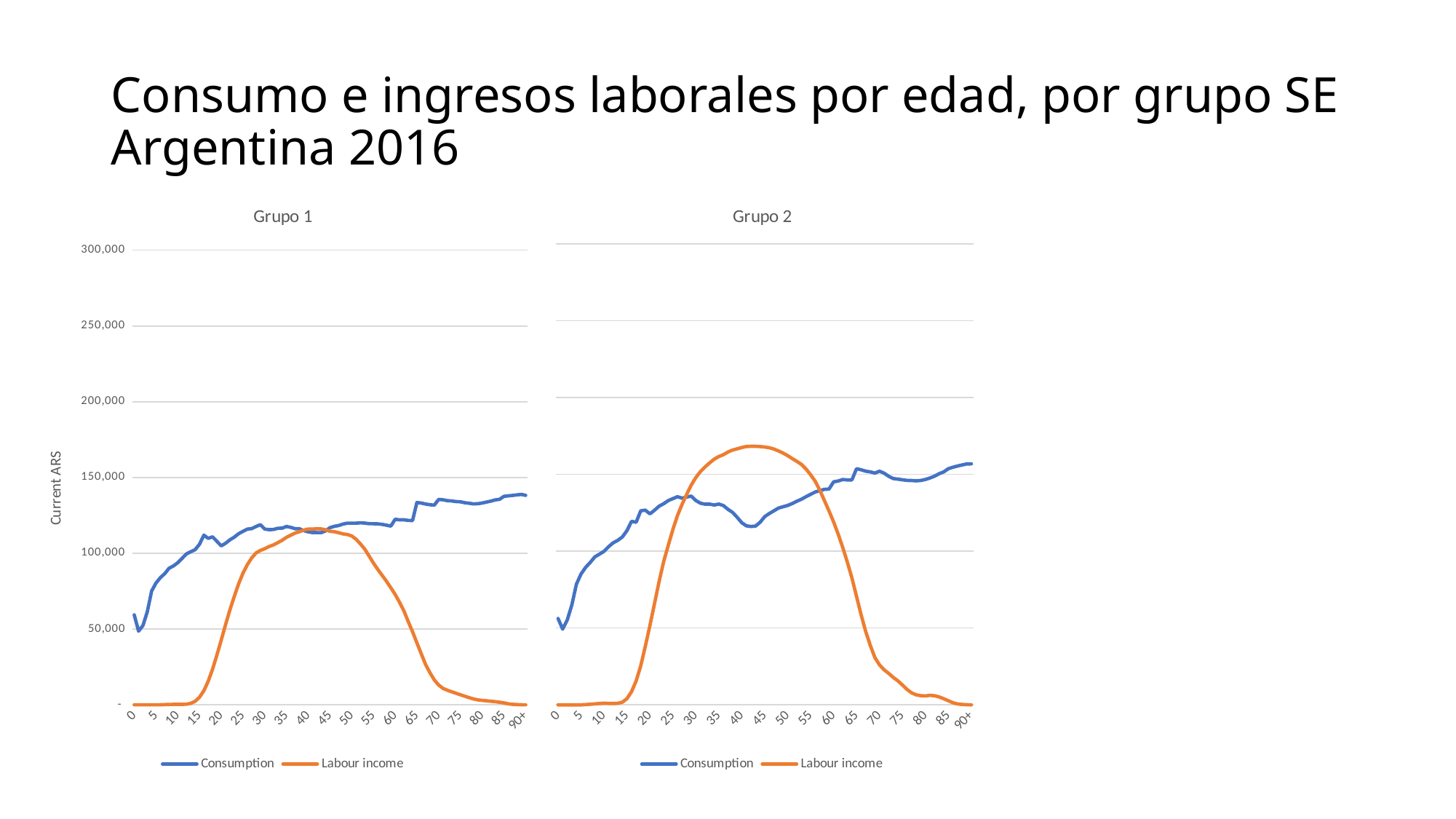
In the Grupo 1 chart, does the Consumption series generally rise or fall from age 0 to age 90+? Rise In the Grupo 1 chart, is the Labour income value at age 40 greater or less than 150,000? less In the Grupo 1 chart, at age 80, which series has the larger value, Consumption or Labour income? Consumption In the Grupo 2 chart, is the Labour income value at age 0 greater or less than 50,000? less What are the two series named in the legend of the Grupo 1 chart? Consumption and Labour income What kind of chart is the Grupo 1 chart? Line chart In the Grupo 2 chart, at age 40, which series has the larger value, Consumption or Labour income? Labour income In the Grupo 2 chart, is the Labour income value at age 40 greater or less than 150,000? greater Which chart shows the higher peak Labour income, Grupo 1 or Grupo 2? Grupo 2 How many series does the legend of the Grupo 2 chart list? 2 What is the label on the vertical axis of the Grupo 1 chart? Current ARS